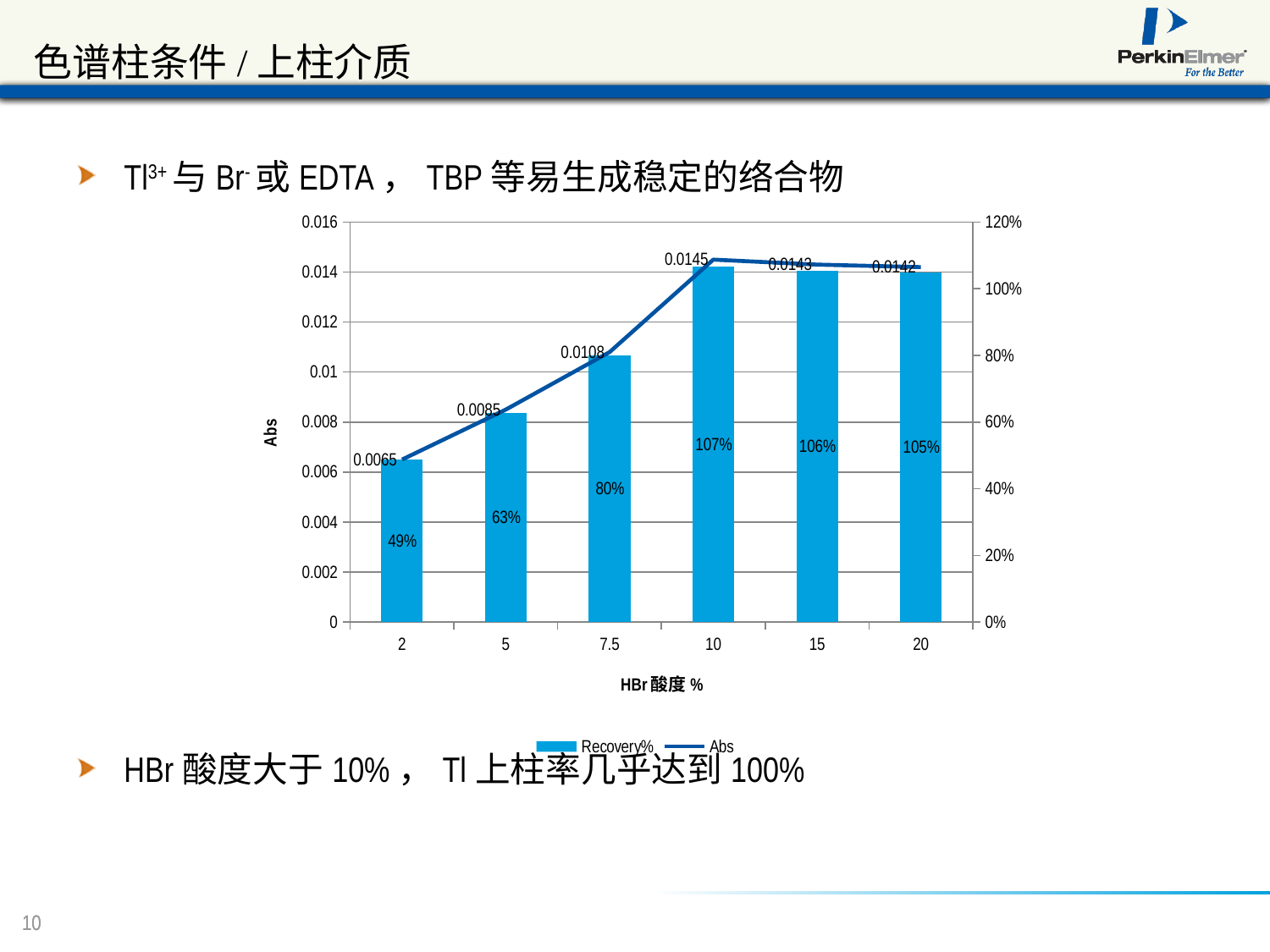
Which has a higher Abs value: HBr acidity 7.5% or 15%? 15 What is the Recovery% value at HBr acidity 2%? 49% How many HBr acidity categories are shown on the x axis? 6 What is the Abs value at HBr acidity 5%? 0.0085 At which HBr acidity is the Abs value lowest? 2 What is the Recovery% value at HBr acidity 7.5%? 80% Which series is drawn as a line in the chart? Abs What is the difference in Recovery% between HBr acidity 7.5% and 5%? 17% At which HBr acidity is the Recovery% highest? 10 What is the Abs value at HBr acidity 10%? 0.0145 How many series does the legend list? 2 Does the Abs value rise or fall from HBr acidity 2% to 10%? rise